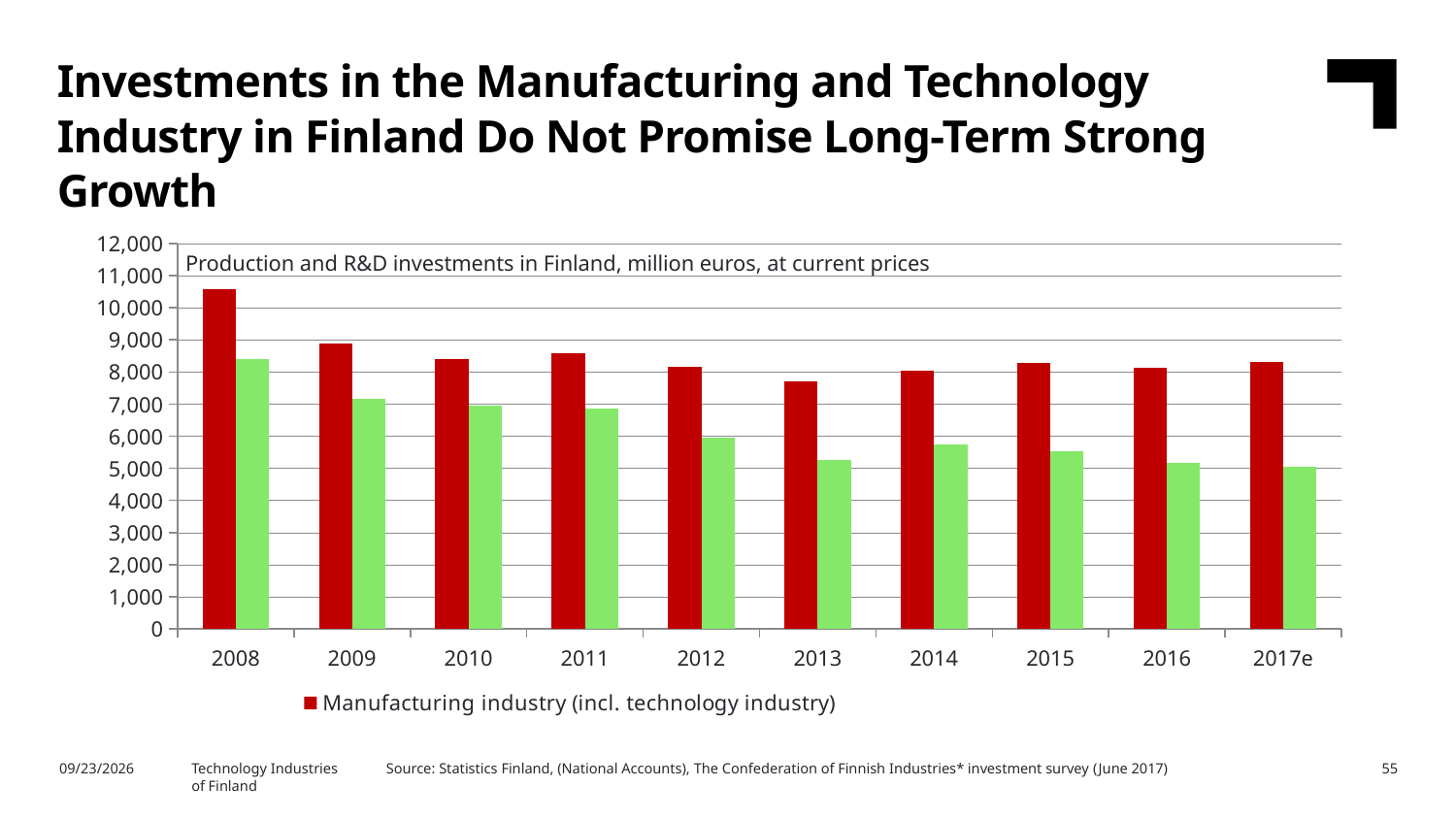
In which year is the Manufacturing industry (incl. technology industry) value highest? 2008 Which year has the larger Manufacturing industry (incl. technology industry) value, 2008 or 2009? 2008 In which year is the Manufacturing industry (incl. technology industry) value lowest? 2013 Do the green bars generally rise or fall from 2008 to 2017e? fall What colour represents Manufacturing industry (incl. technology industry) in the legend? red What kind of chart is shown on the slide? bar chart Is the Manufacturing industry (incl. technology industry) value for 2008 greater or less than 10,000? greater What is the text shown inside the chart describing what is plotted? Production and R&D investments in Finland, million euros, at current prices How many years are shown on the x axis of the chart? 10 How many series does the chart's legend list? 1 Is the Manufacturing industry (incl. technology industry) value for 2013 greater or less than 8,000? less Is the green bar for 2017e greater or less than 6,000? less